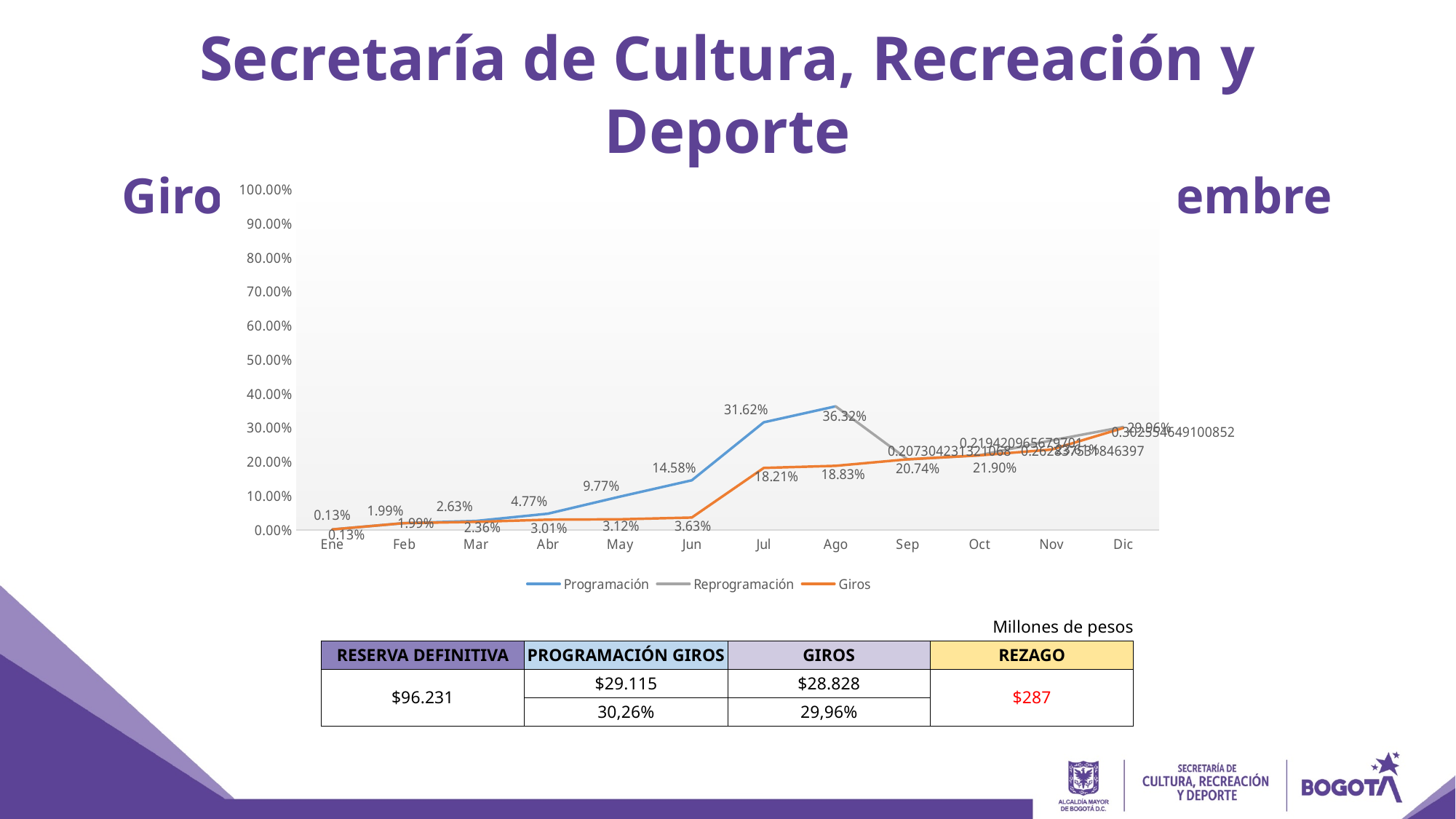
In which month does the Programación series reach its highest value? Ago How many series does the chart legend list? 3 Does the Giros series rise or fall from Ene to Dic? Rise What is the difference between Programación and Giros in Jul? 13.41 percentage points Is the value of Reprogramación in Sep greater or less than 30%? less What is the value of Giros in Dic? 29.96% What is the value of Giros in Jul? 18.21% In Jun, which is larger: Programación or Giros? Programación How many months are shown along the x axis of the chart? 12 What is the value of Giros in Oct? 21.90% What kind of chart is shown on the slide? Line chart What is the value of Programación in Ago? 36.32%